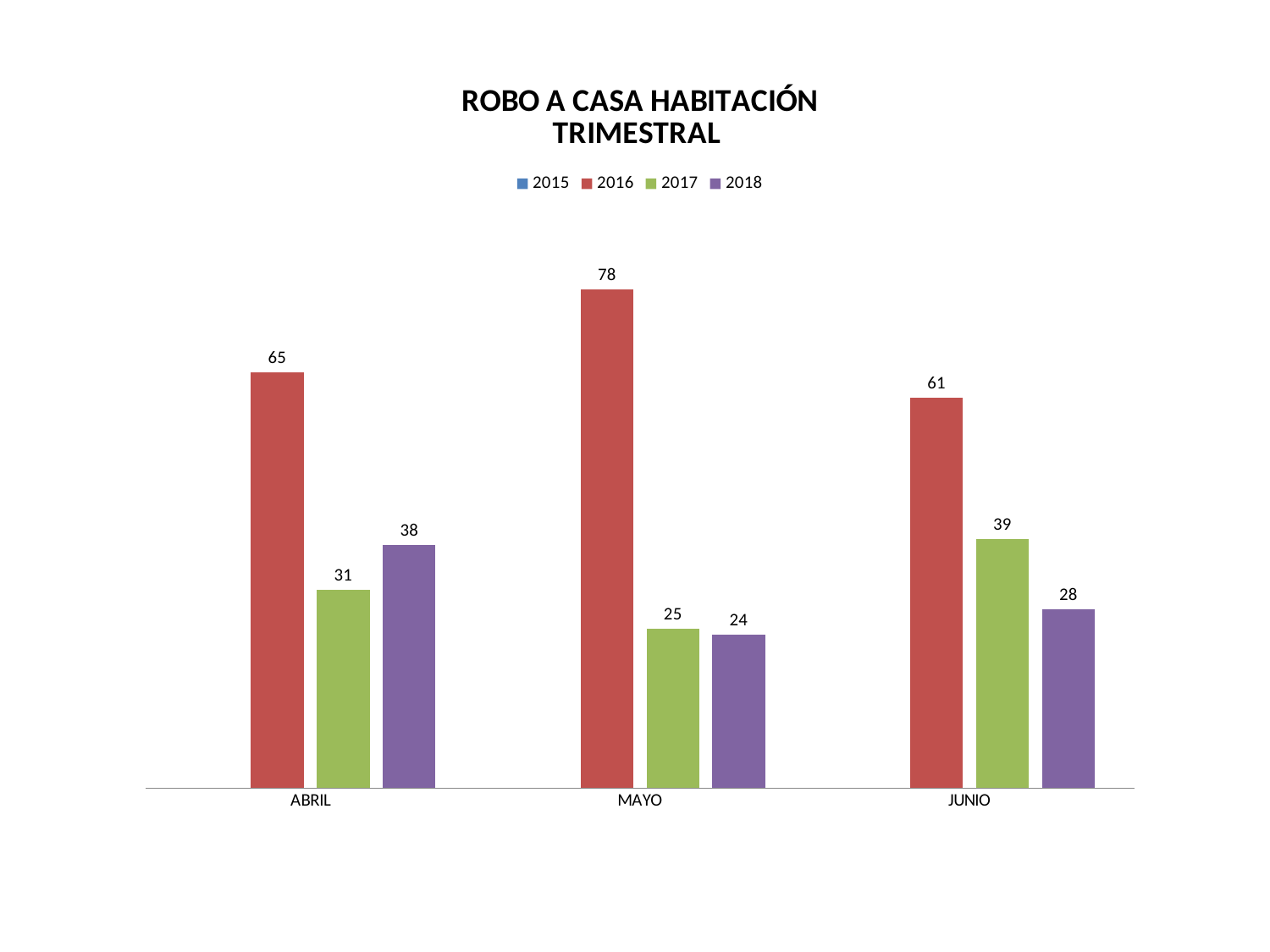
In which month is the 2016 value highest? MAYO In which month is the 2018 value lowest? MAYO What is the difference between the 2016 values for MAYO and ABRIL? 13 What is the title of the chart? ROBO A CASA HABITACIÓN TRIMESTRAL What is the difference between the 2016 and 2017 values in JUNIO? 22 How many months are shown on the x axis? 3 Which is larger in ABRIL, the 2017 value or the 2018 value? 2018 What kind of chart is this? Bar chart How many series does the legend list? 4 What is the value for 2018 in JUNIO? 28 What is the value for 2016 in MAYO? 78 What is the value for 2017 in ABRIL? 31